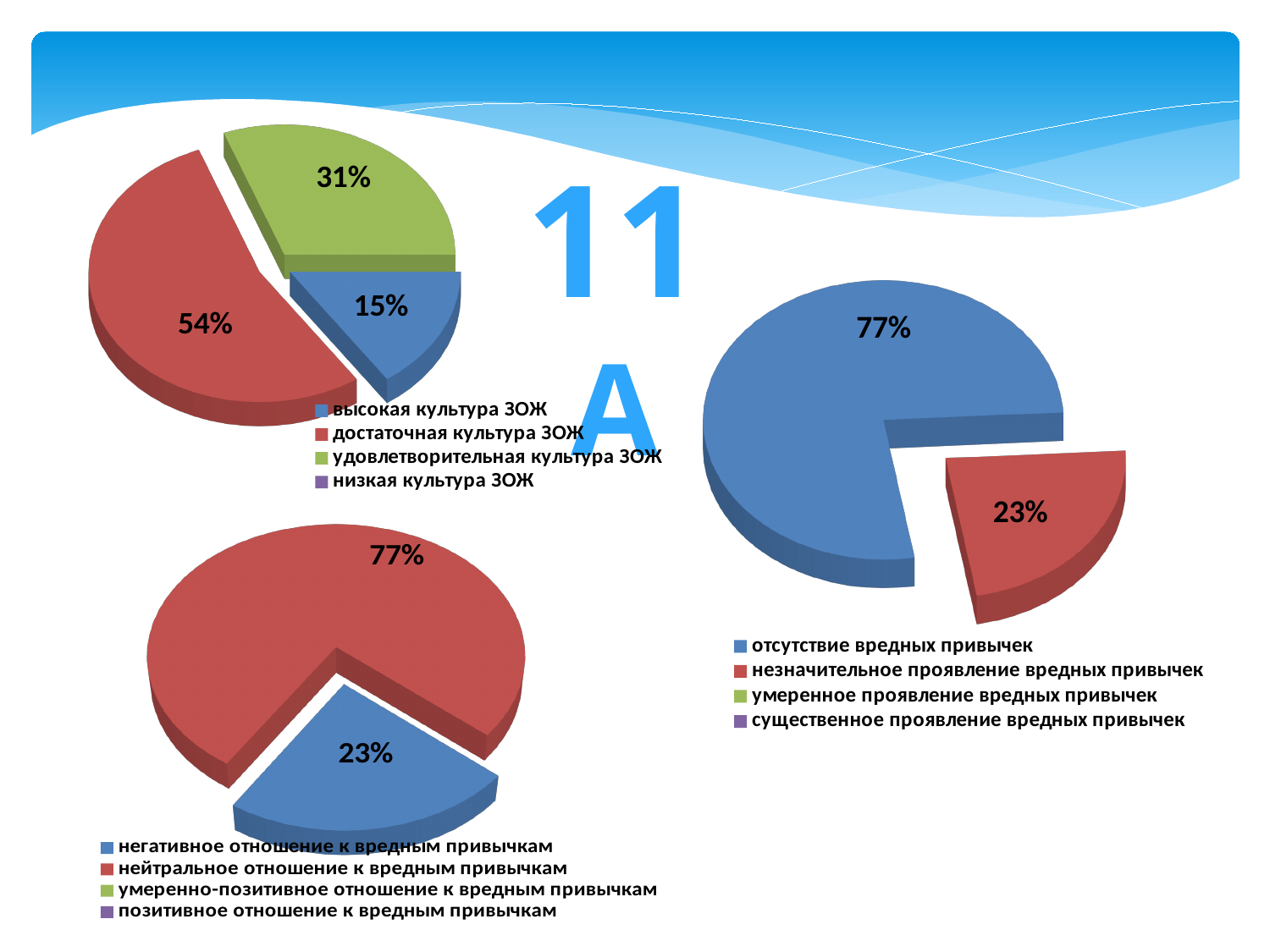
In the top-left pie chart, what share is shown for 'удовлетворительная культура ЗОЖ'? 31% In the top-left pie chart, what share is shown for 'высокая культура ЗОЖ'? 15% In the bottom-left pie chart, what share is shown for 'нейтральное отношение к вредным привычкам'? 77% In the top-left pie chart, what share is shown for 'достаточная культура ЗОЖ'? 54% In the top-left pie chart, how many entries does the legend list? 4 In the pie chart on the right, what share is shown for 'отсутствие вредных привычек'? 77% In the top-left pie chart, which category has the largest slice? достаточная культура ЗОЖ What type of chart is the bottom-left chart? pie chart In the pie chart on the right, which is larger: 'отсутствие вредных привычек' or 'незначительное проявление вредных привычек'? отсутствие вредных привычек In the bottom-left pie chart, what share is shown for 'негативное отношение к вредным привычкам'? 23% In the pie chart on the right, what share is shown for 'незначительное проявление вредных привычек'? 23% In the top-left pie chart, what is the difference between the shares for 'достаточная культура ЗОЖ' and 'высокая культура ЗОЖ'? 39%